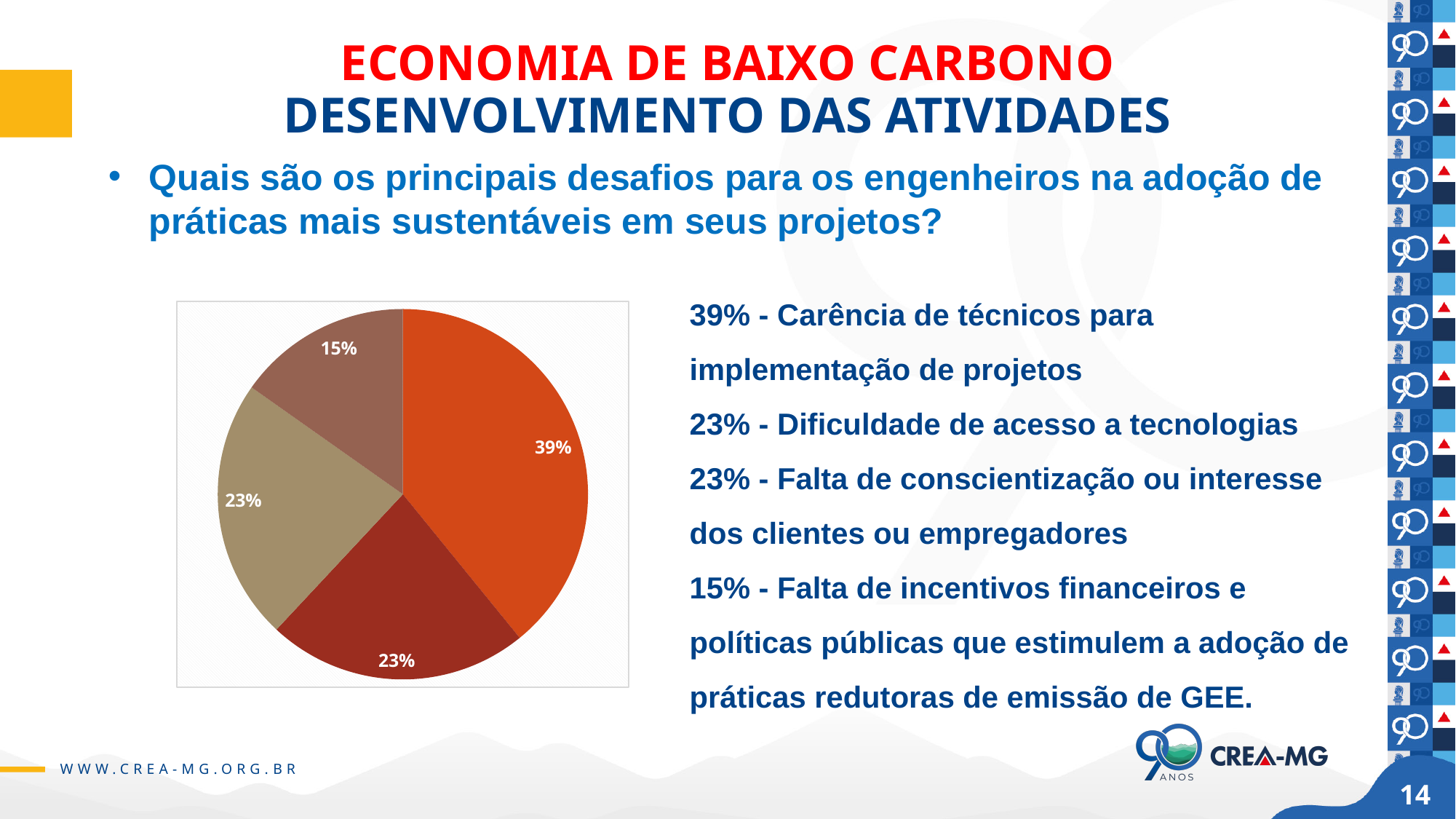
What is the difference between the largest slice (39%) and the smallest slice (15%)? 24% Which is larger: the share for 'Carência de técnicos' or the share for 'Dificuldade de acesso a tecnologias'? Carência de técnicos What percentage corresponds to 'Carência de técnicos para implementação de projetos'? 39% How many slices in the pie chart are labelled 23%? 2 What colour is the largest (39%) slice of the pie chart? orange-red What percentage corresponds to 'Dificuldade de acesso a tecnologias'? 23% What is the smallest share shown in the pie chart? 15% What is the largest share shown in the pie chart? 39% How many slices does the pie chart have? 4 What percentage corresponds to 'Falta de conscientização ou interesse dos clientes ou empregadores'? 23% What percentage corresponds to 'Falta de incentivos financeiros e políticas públicas'? 15% What kind of chart is shown on the slide? pie chart